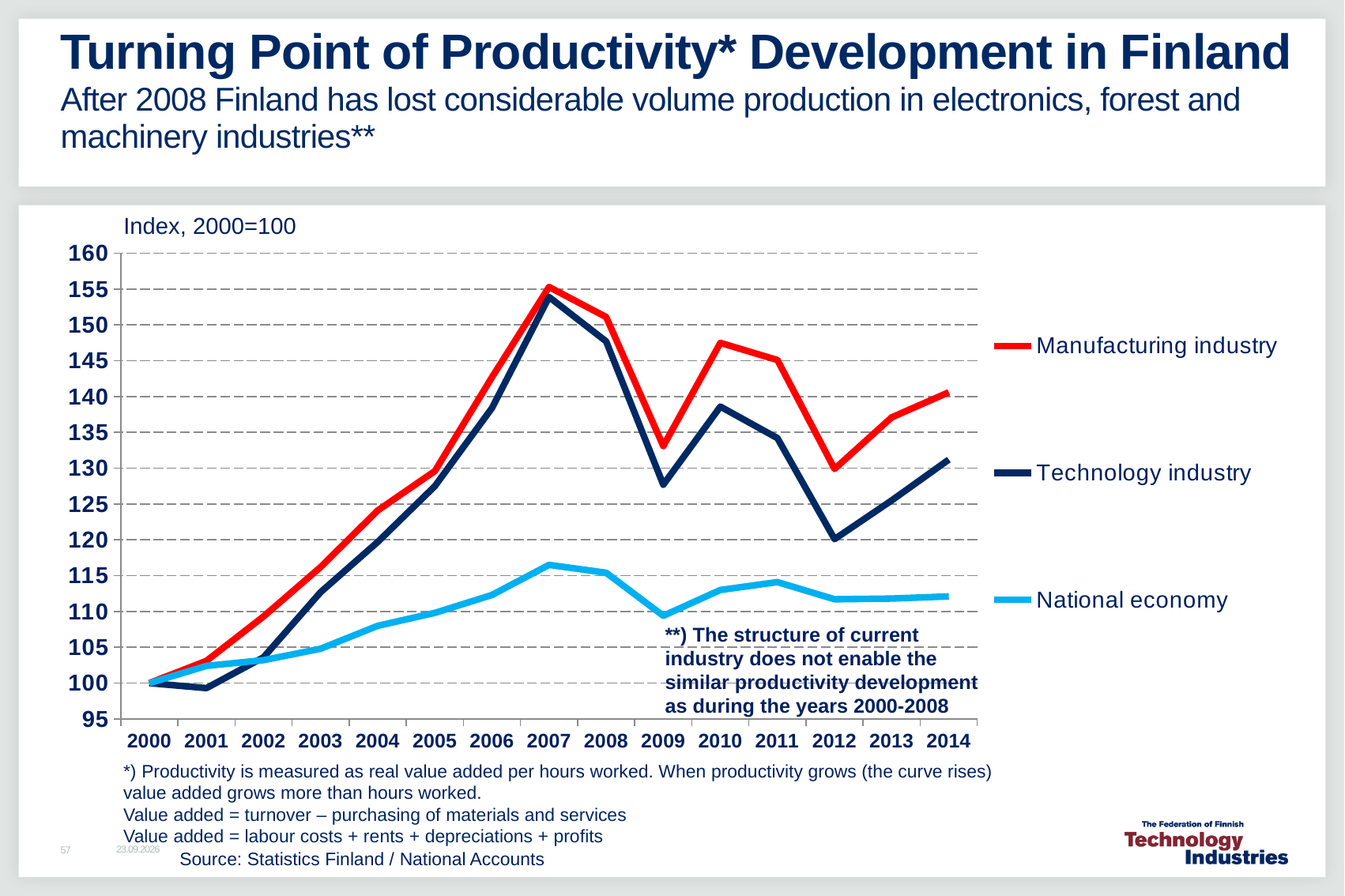
What does the label above the y axis say the values are? Index, 2000=100 Is the value for Technology industry in 2010 greater or less than 140? less How many series does the legend list? 3 Is the value for National economy in 2014 greater or less than 110? greater What kind of chart is shown on the slide? line chart How many years are shown on the x axis? 15 In which year does the Manufacturing industry line reach its highest value? 2007 Is the value for Manufacturing industry in 2007 greater or less than 150? greater Which series has the highest value in 2014? Manufacturing industry Which series has the lowest value in 2014? National economy What is the index value for Manufacturing industry in 2000? 100 Does the National economy line rise or fall between 2000 and 2007? rise